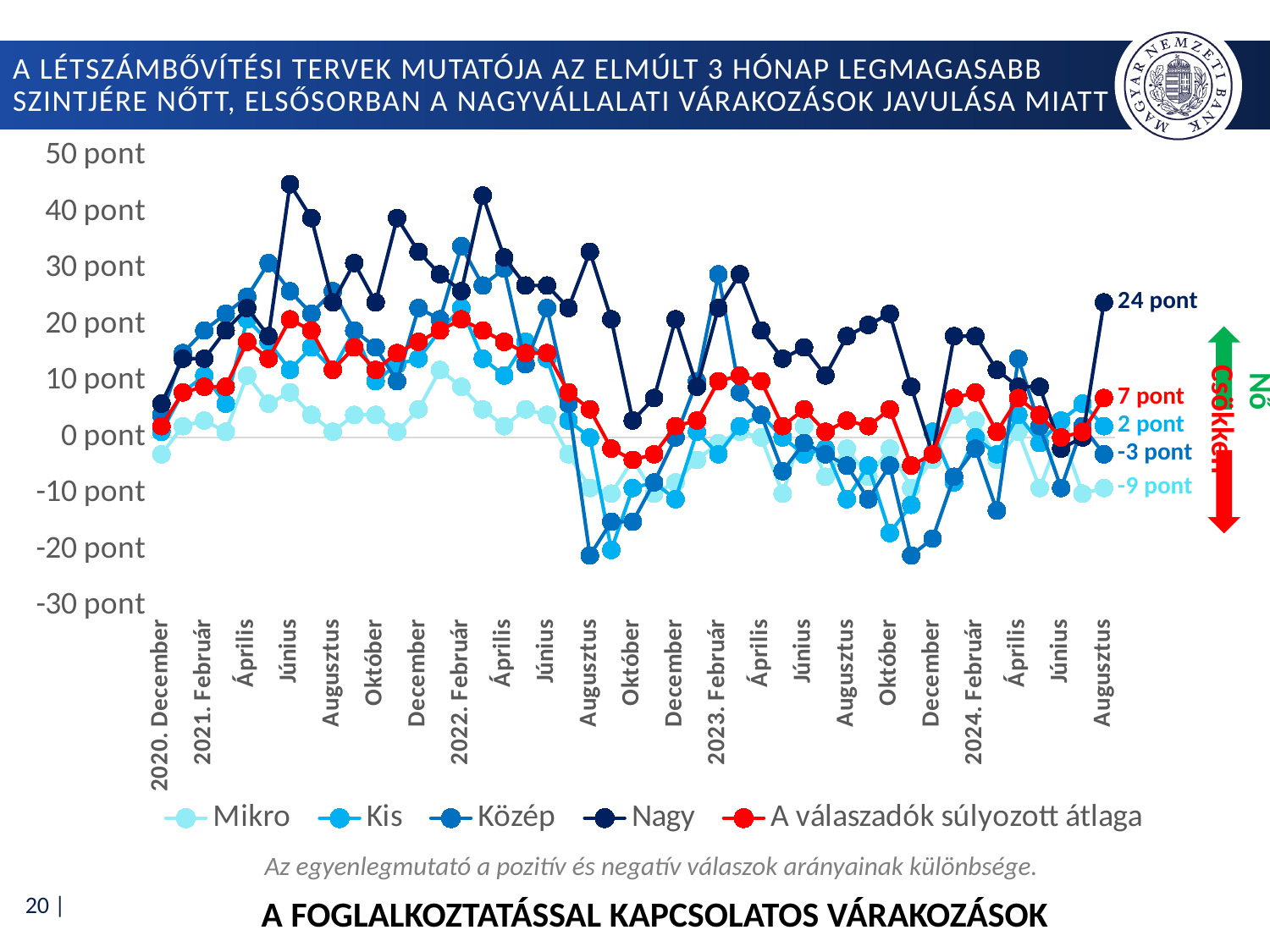
What is the value for Közép at the last point (2024 Augusztus)? -3 pont Is the value for Nagy in 2021 Június greater or less than 40 pont? greater What is the value for Nagy at the last point (2024 Augusztus)? 24 pont How many series does the legend list? 5 Which series has the lowest value at the last point (2024 Augusztus)? Mikro What colour is the line for A válaszadók súlyozott átlaga? red What is the value for Mikro at the last point (2024 Augusztus)? -9 pont Which series has the highest value at the last point (2024 Augusztus)? Nagy What is the value for A válaszadók súlyozott átlaga at the last point (2024 Augusztus)? 7 pont What kind of chart is shown on the slide? line chart What is the difference between the Nagy and Mikro values at the last point (2024 Augusztus)? 33 pont At the last point (2024 Augusztus), which is larger: the Kis value or the Közép value? Kis